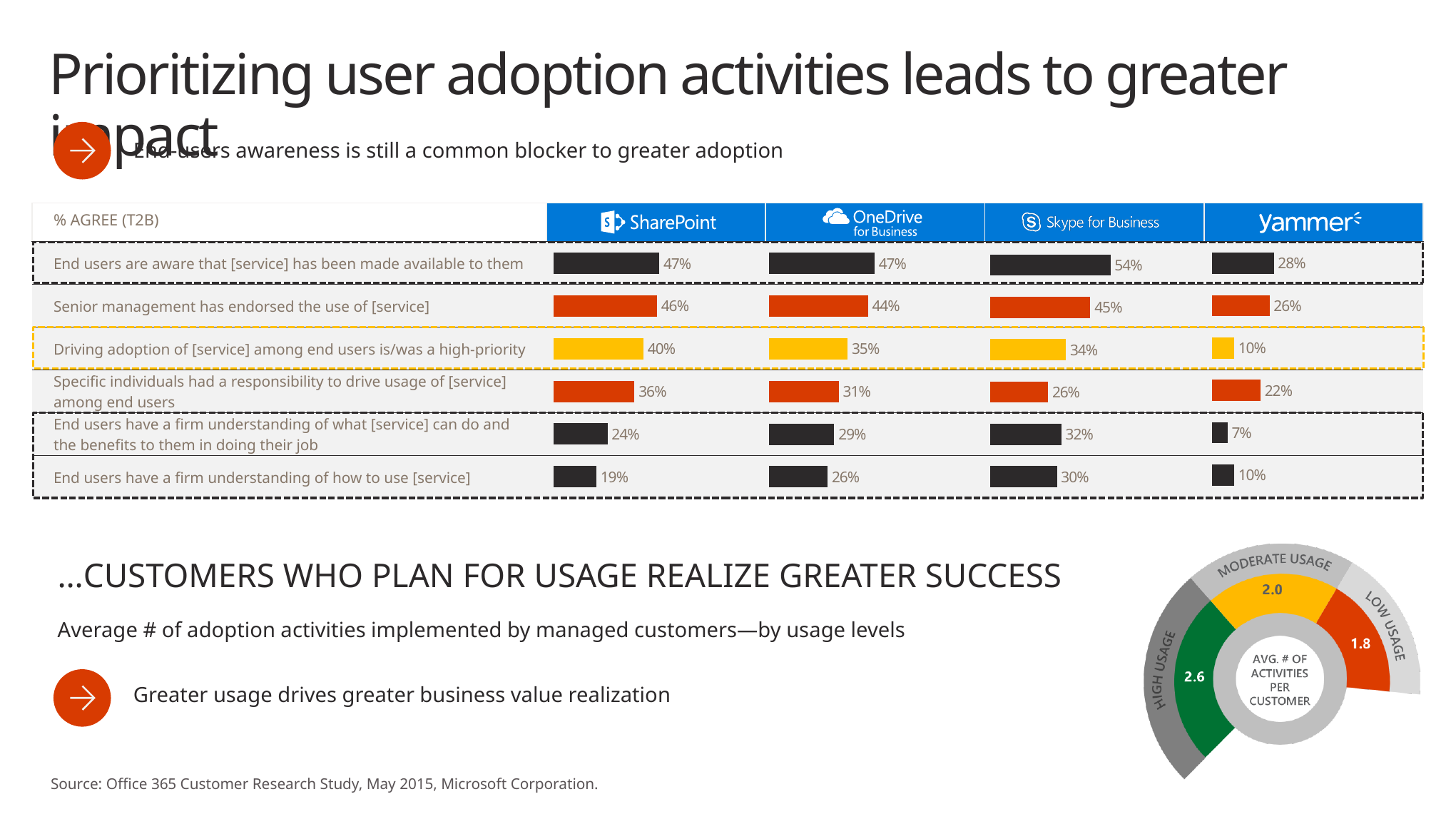
In the % AGREE (T2B) bar chart, what is the Yammer value for 'Driving adoption of [service] among end users is/was a high-priority'? 10% In the % AGREE (T2B) bar chart, what is the SharePoint value for 'Senior management has endorsed the use of [service]'? 46% How many statements (rows) are shown in the % AGREE (T2B) bar chart? 6 In the % AGREE (T2B) bar chart, which service has the lowest value for 'End users have a firm understanding of what [service] can do and the benefits to them in doing their job'? Yammer How many services (columns) are compared in the % AGREE (T2B) bar chart? 4 In the % AGREE (T2B) bar chart, which service has the highest value for 'End users are aware that [service] has been made available to them'? Skype for Business In the % AGREE (T2B) bar chart, what percentage of Skype for Business respondents agree that end users are aware the service has been made available to them? 54% In the % AGREE (T2B) bar chart, which is larger for 'End users have a firm understanding of how to use [service]': SharePoint or Skype for Business? Skype for Business In the % AGREE (T2B) bar chart, what is the difference between the SharePoint and OneDrive for Business values for 'Specific individuals had a responsibility to drive usage of [service] among end users'? 5% In the gauge chart at the bottom right, what is the average number of activities per customer for low usage customers? 1.8 In the gauge chart at the bottom right, what is the difference between the high usage and moderate usage values? 0.6 In the gauge chart at the bottom right, what is the average number of adoption activities per customer for high usage customers? 2.6